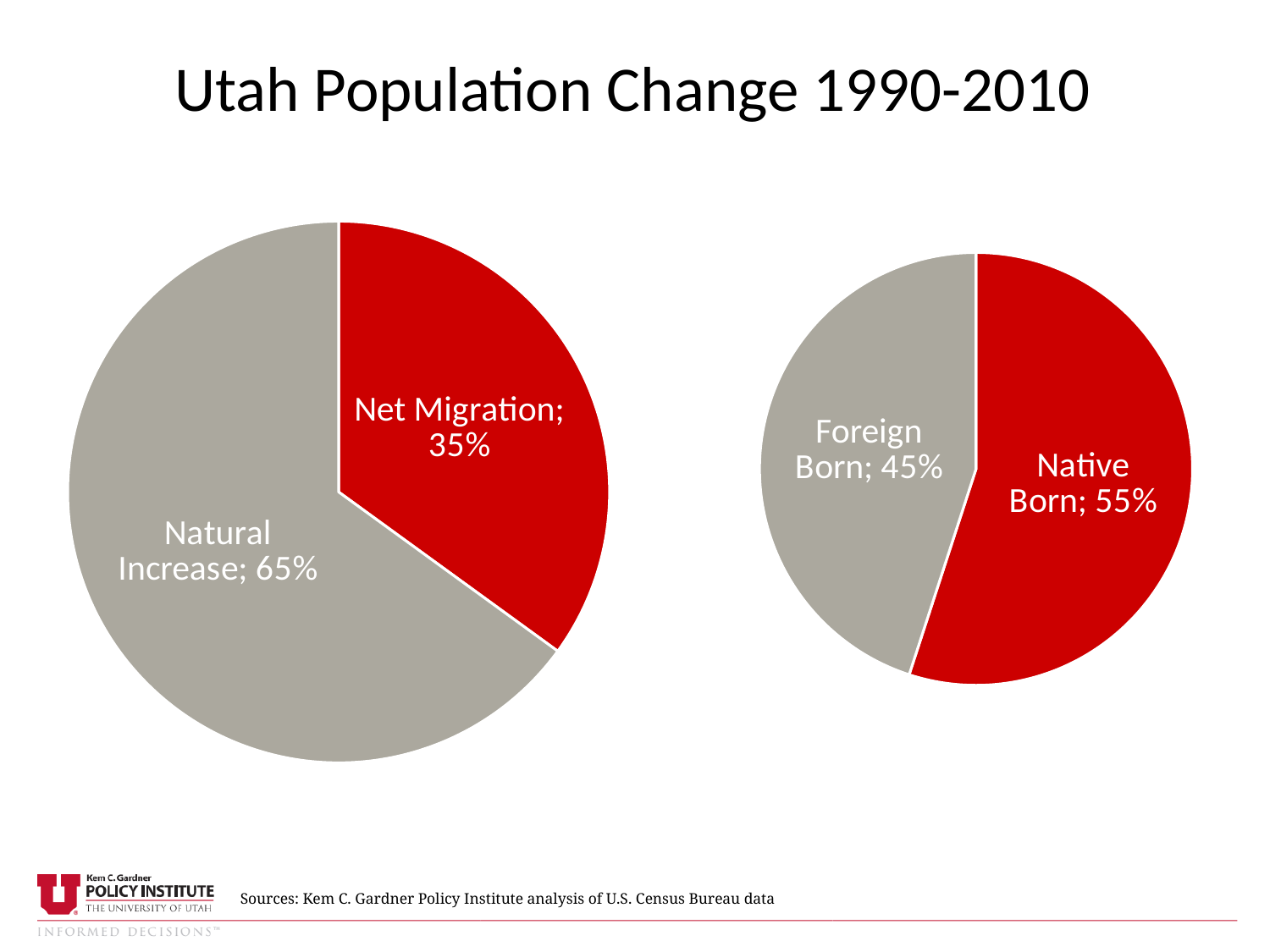
In the right pie chart, what share is labelled for Foreign Born? 45% In the right pie chart, what is the difference in percentage points between Native Born and Foreign Born? 10 percentage points In the left pie chart, what is the difference in percentage points between Natural Increase and Net Migration? 30 percentage points How many slices does the left pie chart have? 2 In the left pie chart, what share is labelled for Net Migration? 35% What colour is the Net Migration slice in the left pie chart? Red In the left pie chart, what share is labelled for Natural Increase? 65% What type of chart is shown on the left of the slide? Pie chart In the right pie chart, which is larger, Native Born or Foreign Born? Native Born In the left pie chart, which slice is the largest? Natural Increase In the right pie chart, which slice is the smallest? Foreign Born